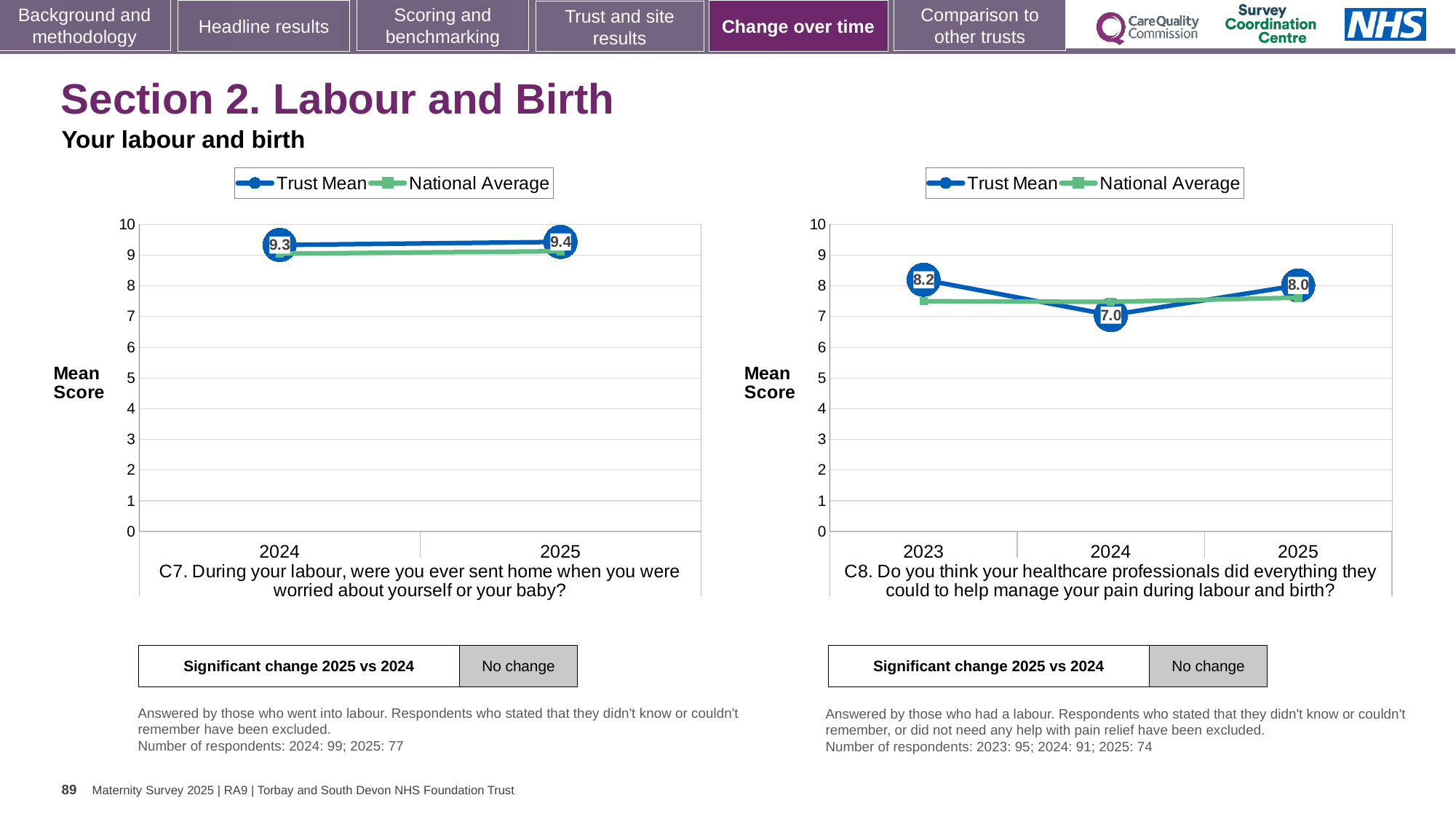
In the C8 chart, which year has the lowest Trust Mean? 2024 What kind of chart is the C7 chart? line chart How many years are shown on the x axis of the C8 chart? 3 In the C7 chart, what is the Trust Mean for 2024? 9.3 In the C7 chart, what is the difference between the Trust Mean for 2025 and for 2024? 0.1 In the C8 chart, is the Trust Mean for 2024 larger or smaller than the National Average for 2024? smaller In the C8 chart, what is the difference between the Trust Mean for 2023 and for 2024? 1.2 In the C7 chart, what is the Trust Mean for 2025? 9.4 In the C8 chart, is the National Average for 2024 greater or less than 7? greater In the C8 chart, which year has the highest Trust Mean? 2023 In the C8 chart, what is the Trust Mean for 2024? 7.0 How many series does the legend of the C7 chart list? 2